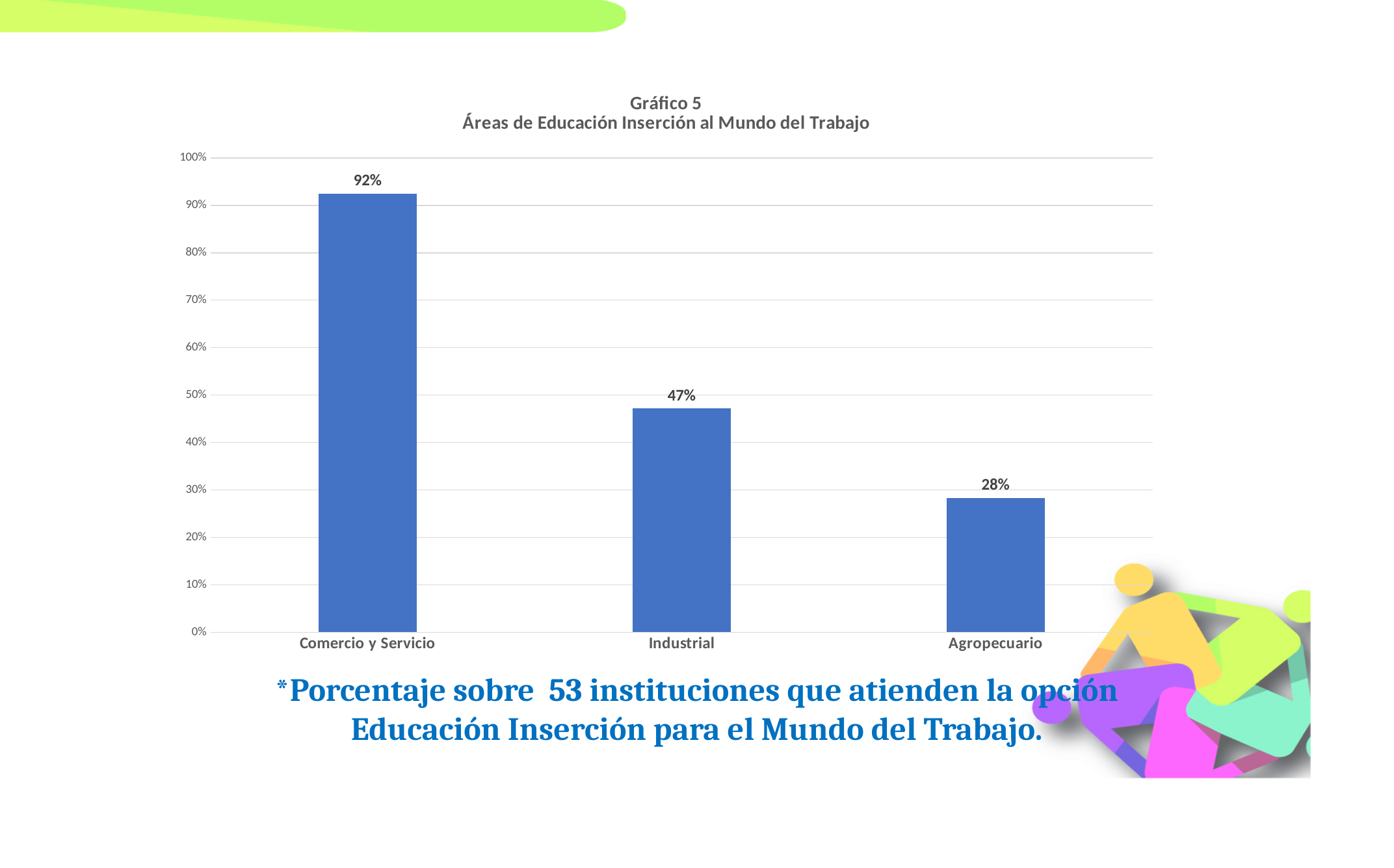
Which category has the lowest value? Agropecuario What is the value for Agropecuario? 28% What is the difference between the values for Comercio y Servicio and Industrial? 45% What is the value for Comercio y Servicio? 92% Which is larger, the value for Industrial or the value for Agropecuario? Industrial Is the value for Industrial greater or less than 50%? less What is the title of the chart? Gráfico 5 Áreas de Educación Inserción al Mundo del Trabajo How many categories are shown on the chart? 3 Which category has the highest value? Comercio y Servicio What is the difference between the values for Industrial and Agropecuario? 19% What is the value for Industrial? 47% What kind of chart is shown on the slide? bar chart